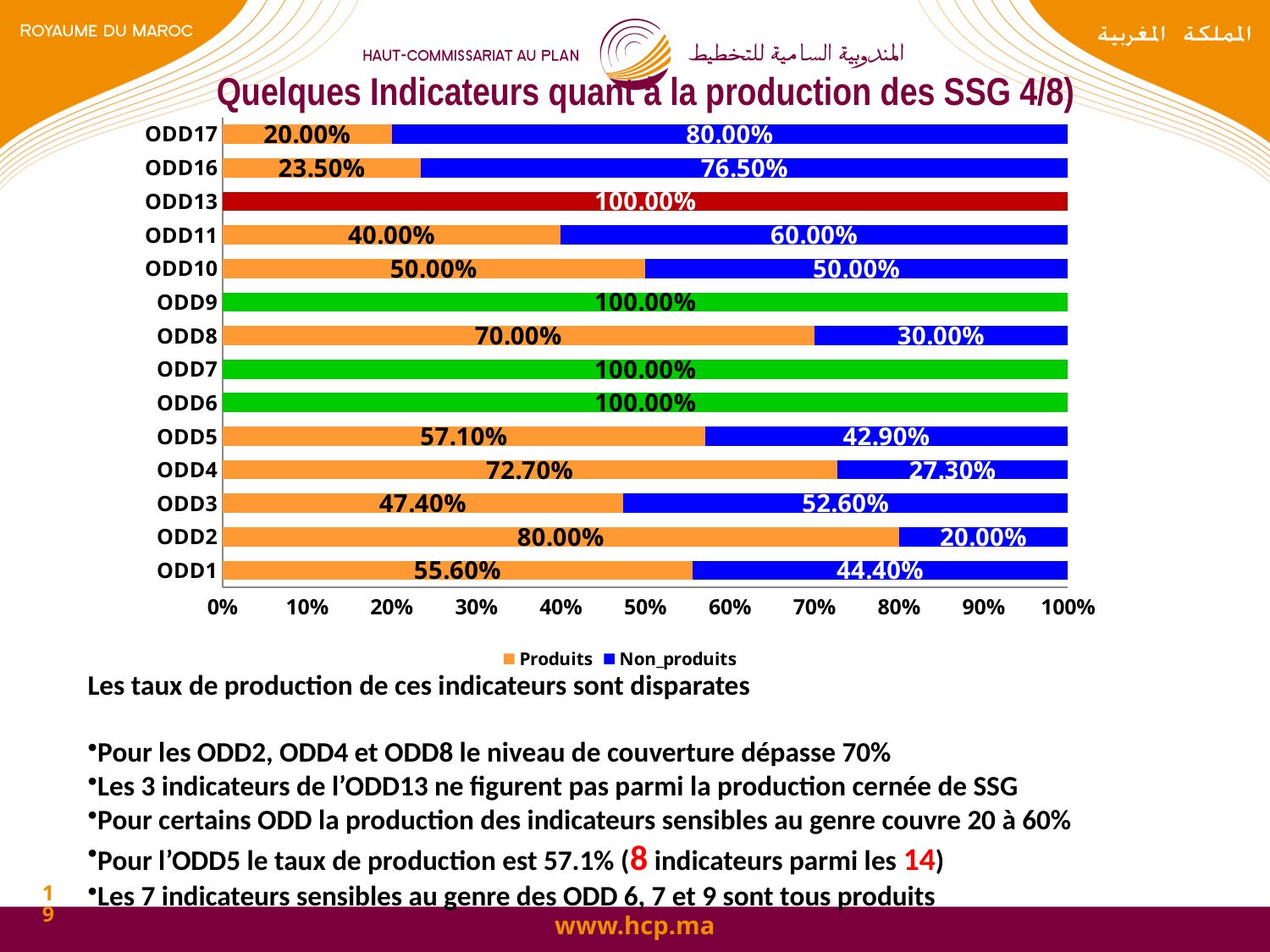
Which is larger for ODD3: the Produits value or the Non_produits value? Non_produits How many series does the legend list? 2 What is the Non_produits value for ODD11? 60.00% Is the Produits value for ODD4 greater or less than 70%? greater What is the difference between the Produits and Non_produits values for ODD8? 40.00% How many ODD categories are shown on the chart? 14 What is the Produits value for ODD5? 57.10% Which ODD has the lowest Produits share among the bars with an orange segment? ODD17 What kind of chart is shown on the slide? Stacked bar chart What is the total of the stacked bar for ODD10? 100.00% What is the Produits value for ODD2? 80.00% What is the Non_produits value for ODD16? 76.50%